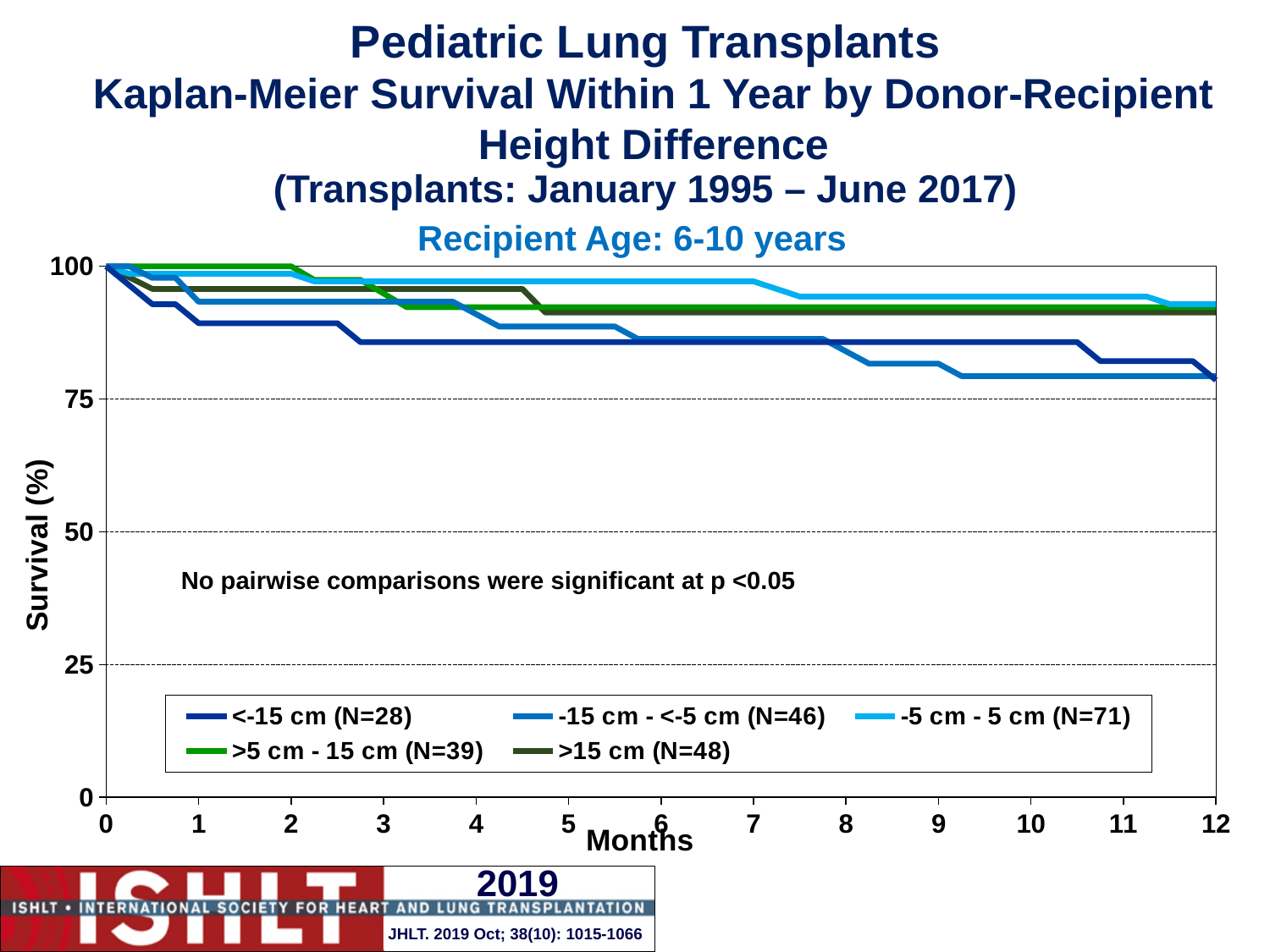
Which group has the largest N according to the legend? -5 cm - 5 cm (N=71) Which group has the highest survival at 6 months? -5 cm - 5 cm (N=71) Is the survival value for the <-15 cm group at 12 months greater or less than 100? less What kind of chart is shown on the slide? line chart Is the survival value for the >15 cm group at 6 months greater or less than 75? greater What is the maximum value shown on the Months axis? 12 Which group has the smallest N according to the legend? <-15 cm (N=28) Is the survival value for the -5 cm - 5 cm group at 12 months greater or less than 75? greater At 6 months, is survival higher for the -5 cm - 5 cm group or the <-15 cm group? -5 cm - 5 cm How many series does the legend list? 5 Do the survival curves rise or fall as months increase? fall